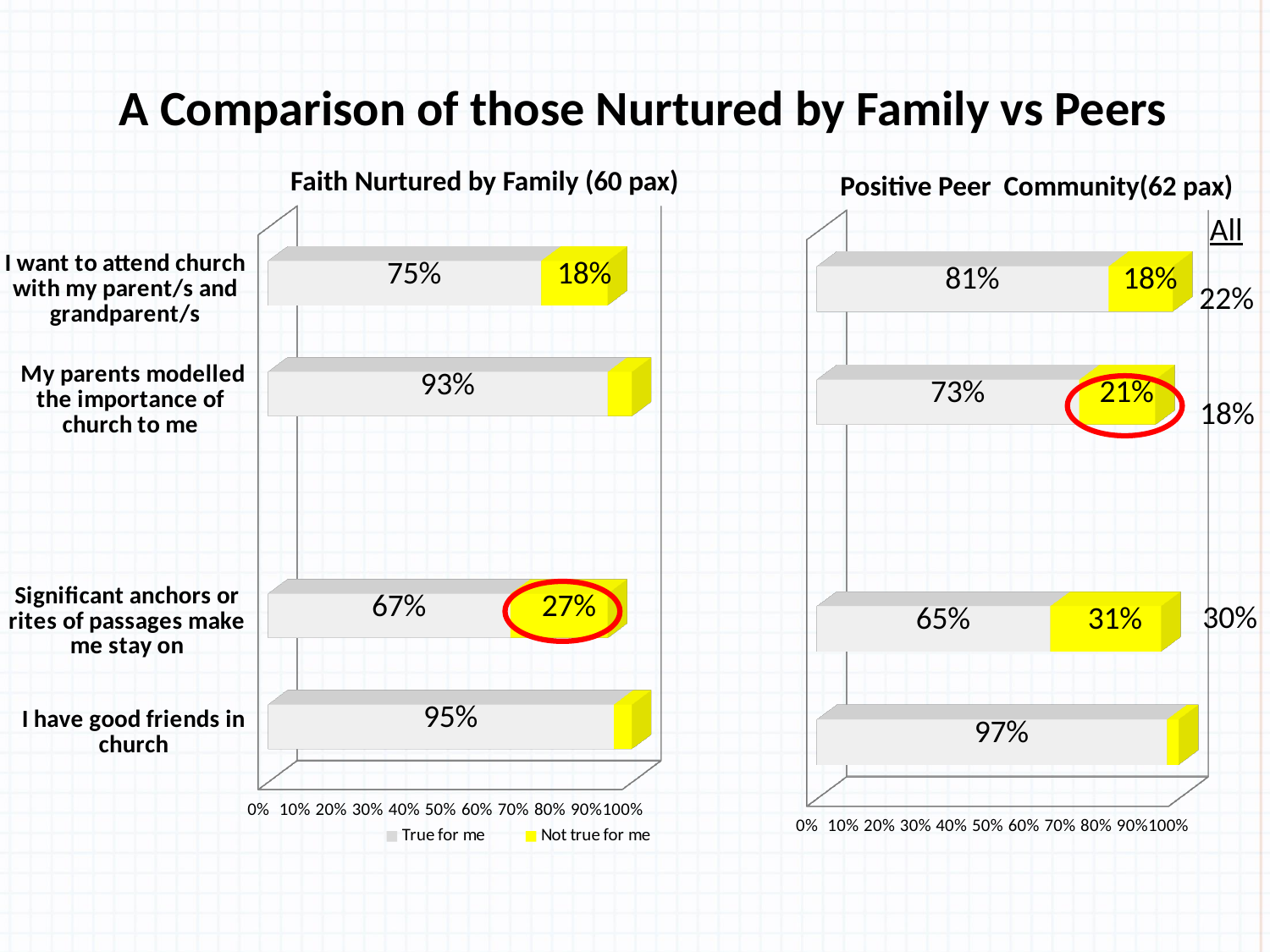
In the Faith Nurtured by Family (60 pax) chart, what is the total of the labelled 'True for me' and 'Not true for me' values for 'I want to attend church with my parent/s and grandparent/s'? 93% How many statements (categories) are shown in the Positive Peer Community (62 pax) chart? 4 In the Positive Peer Community (62 pax) chart, which statement has the lowest 'True for me' value? Significant anchors or rites of passages make me stay on In the Faith Nurtured by Family (60 pax) chart, what is the difference between the 'True for me' values for 'My parents modelled the importance of church to me' and 'I want to attend church with my parent/s and grandparent/s'? 18 percentage points How many series does the legend of the Faith Nurtured by Family (60 pax) chart list? 2 What type of chart is the Faith Nurtured by Family (60 pax) chart? Bar chart In the Faith Nurtured by Family (60 pax) chart, what is the 'True for me' value for 'I have good friends in church'? 95% In the Faith Nurtured by Family (60 pax) chart, which statement has the highest 'True for me' value? I have good friends in church In the Positive Peer Community (62 pax) chart, what is the 'Not true for me' value for 'Significant anchors or rites of passages make me stay on'? 31% For 'My parents modelled the importance of church to me', which chart shows the larger 'True for me' value: Faith Nurtured by Family or Positive Peer Community? Faith Nurtured by Family In the Positive Peer Community (62 pax) chart, what is the 'True for me' value for 'I want to attend church with my parent/s and grandparent/s'? 81% In the Faith Nurtured by Family (60 pax) chart, what colour represents the 'Not true for me' series? Yellow